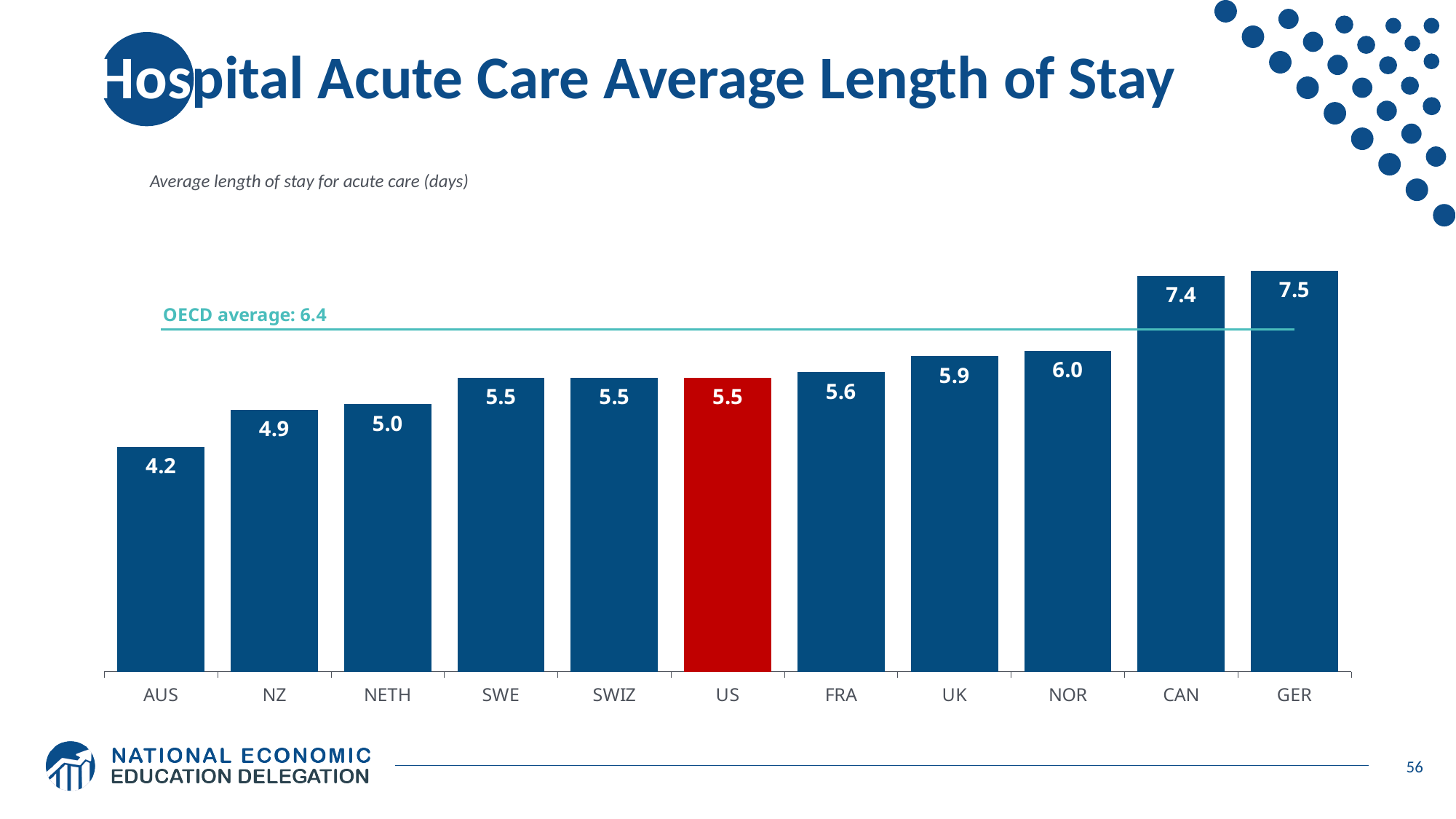
What is the average length of stay for acute care in Australia (AUS)? 4.2 Which country's bar is highlighted in red? US What is the average length of stay for acute care in Germany (GER)? 7.5 What is the difference in average length of stay between GER and AUS? 3.3 How many countries are shown in the chart? 11 What is the average length of stay for acute care in the US? 5.5 Which country has the highest average length of stay for acute care? GER What is the OECD average length of stay shown on the chart? 6.4 What is the difference in average length of stay between CAN and the US? 1.9 Which has a longer average length of stay, NOR or NZ? NOR Which country has the lowest average length of stay for acute care? AUS What type of chart is shown on the slide? Bar chart